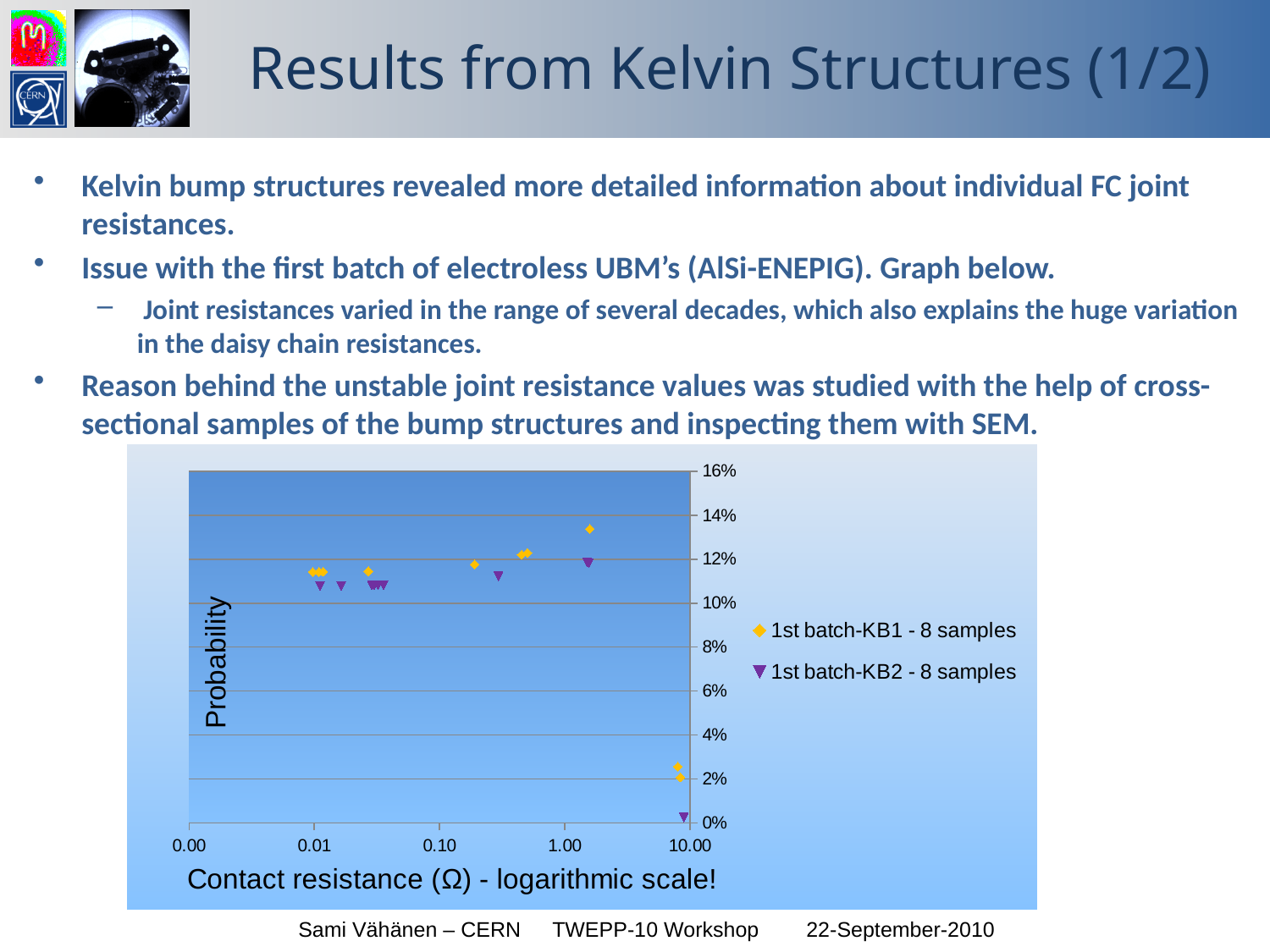
How many series does the chart legend list? 2 Is the 1st batch-KB1 - 8 samples point near 0.03 Ω greater or less than 10%? greater Is the lowest point of the 1st batch-KB2 - 8 samples series greater or less than 2%? less Are the 1st batch-KB2 - 8 samples points near 0.01 Ω greater or less than 10%? greater What kind of chart is shown on the slide? scatter chart What are the two series names listed in the chart legend? 1st batch-KB1 - 8 samples; 1st batch-KB2 - 8 samples What is the label of the chart's x axis? Contact resistance (Ω) - logarithmic scale! Which series contains the single highest probability point on the chart? 1st batch-KB1 - 8 samples